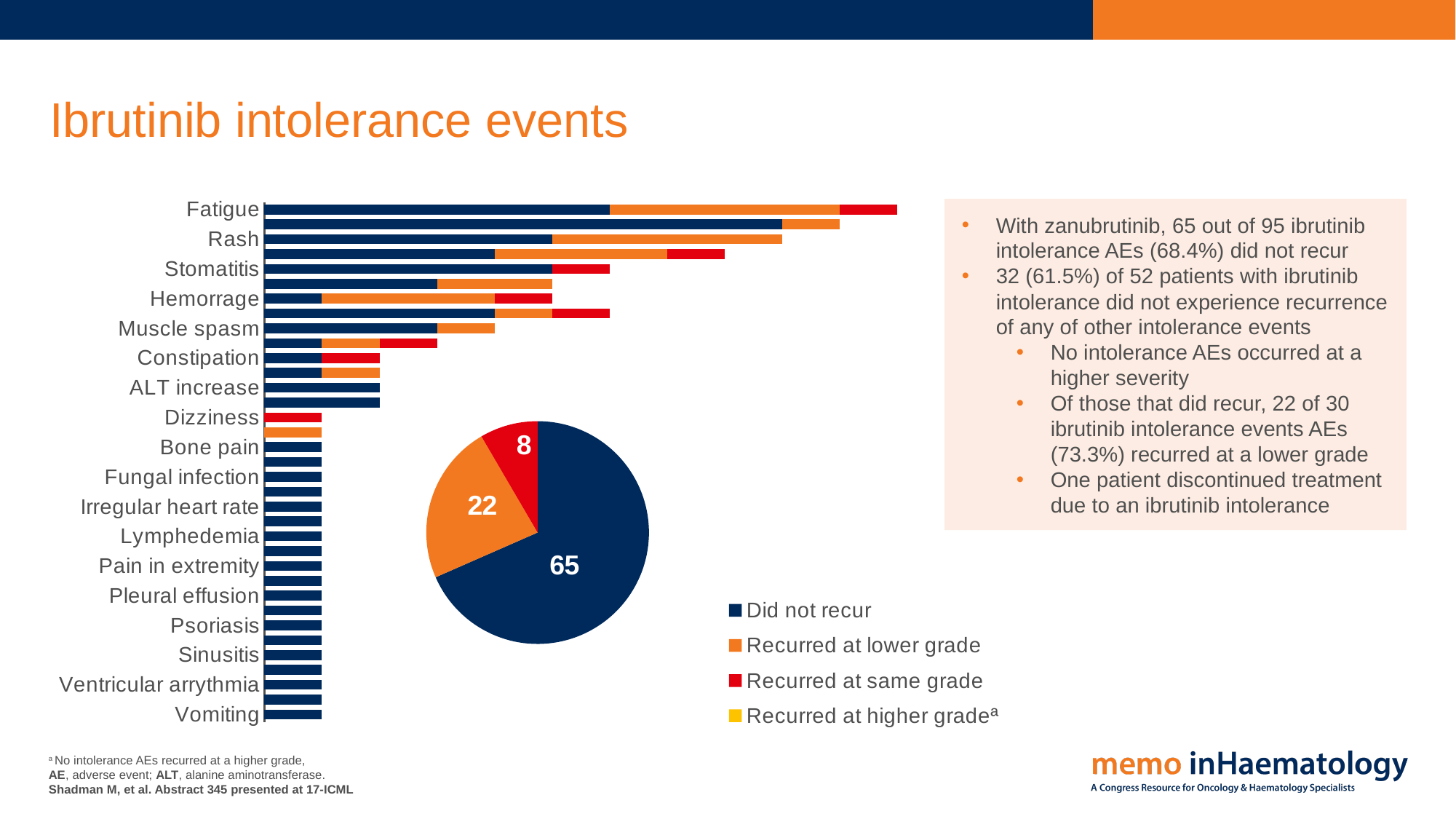
In the pie chart, what is the total of the three labelled slices? 95 In the pie chart, what is the difference between the 'Did not recur' value and the 'Recurred at lower grade' value? 43 How many entries does the legend list? 4 In the bar chart on the left, which category has the longest bar? Fatigue In the pie chart, what share of the total does the 'Did not recur' slice represent? 68.4% In the pie chart, which category has the largest slice? Did not recur In the pie chart, what is the value for 'Did not recur'? 65 In the pie chart, which of the labelled slices is the smallest? Recurred at same grade What kind of chart is the chart on the left listing Fatigue, Rash, Stomatitis and other events? Bar chart In the pie chart, what is the value for 'Recurred at lower grade'? 22 In the pie chart, which is larger: 'Recurred at lower grade' or 'Recurred at same grade'? Recurred at lower grade In the pie chart, what is the value for 'Recurred at same grade'? 8